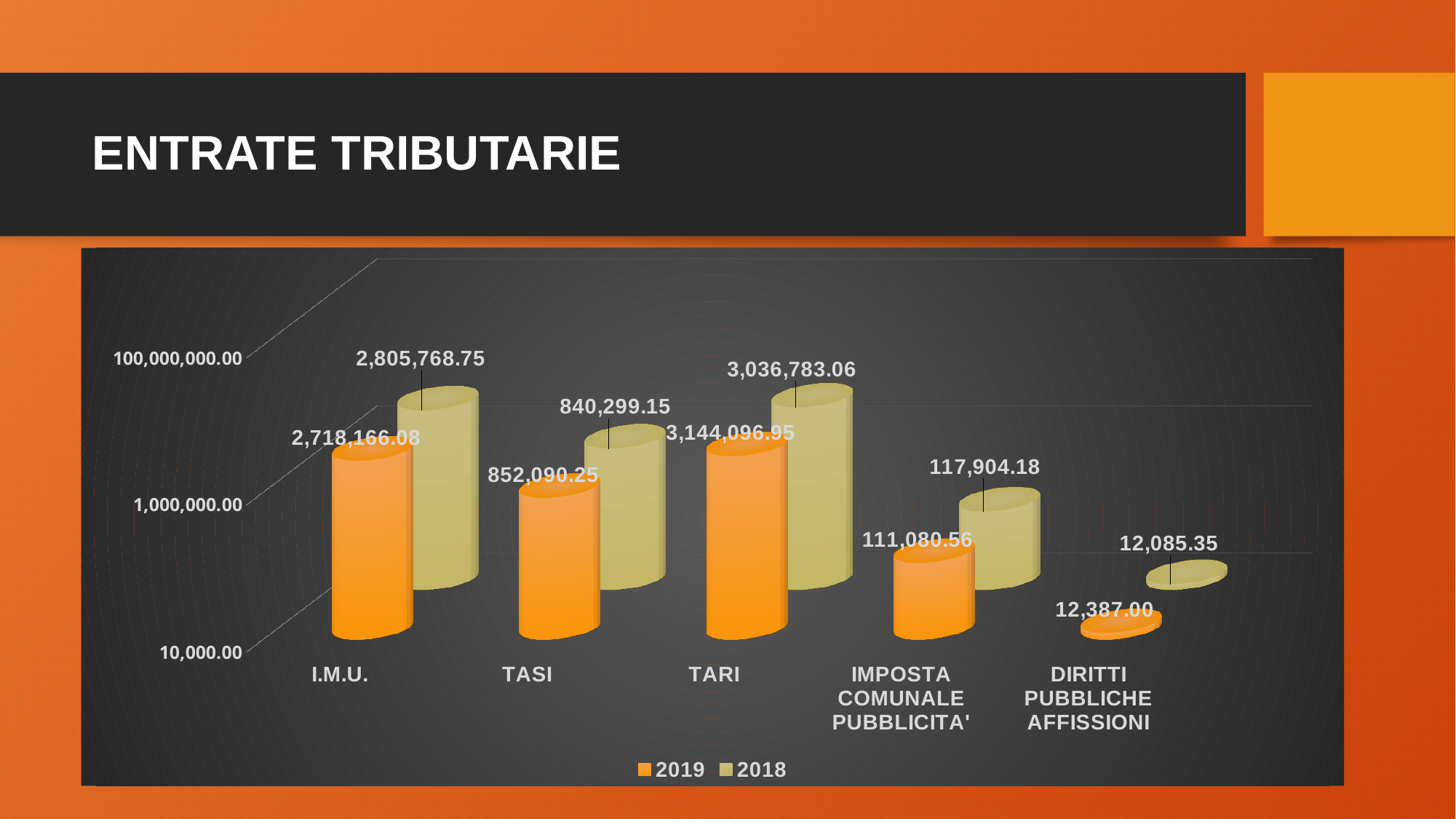
What is the 2019 value for IMPOSTA COMUNALE PUBBLICITA'? 111,080.56 What is the 2019 value for TARI? 3,144,096.95 What is the difference between the 2018 and 2019 values for I.M.U.? 87,602.67 What is the 2018 value for DIRITTI PUBBLICHE AFFISSIONI? 12,085.35 How many categories are shown on the x axis? 5 What kind of chart is shown on the slide? Bar chart Which category has the highest 2019 value? TARI What is the difference between the 2019 and 2018 values for TARI? 107,313.89 Which category has the lowest 2018 value? DIRITTI PUBBLICHE AFFISSIONI What is the 2018 value for I.M.U.? 2,805,768.75 For TASI, which year has the larger value, 2019 or 2018? 2019 How many series does the legend list? 2